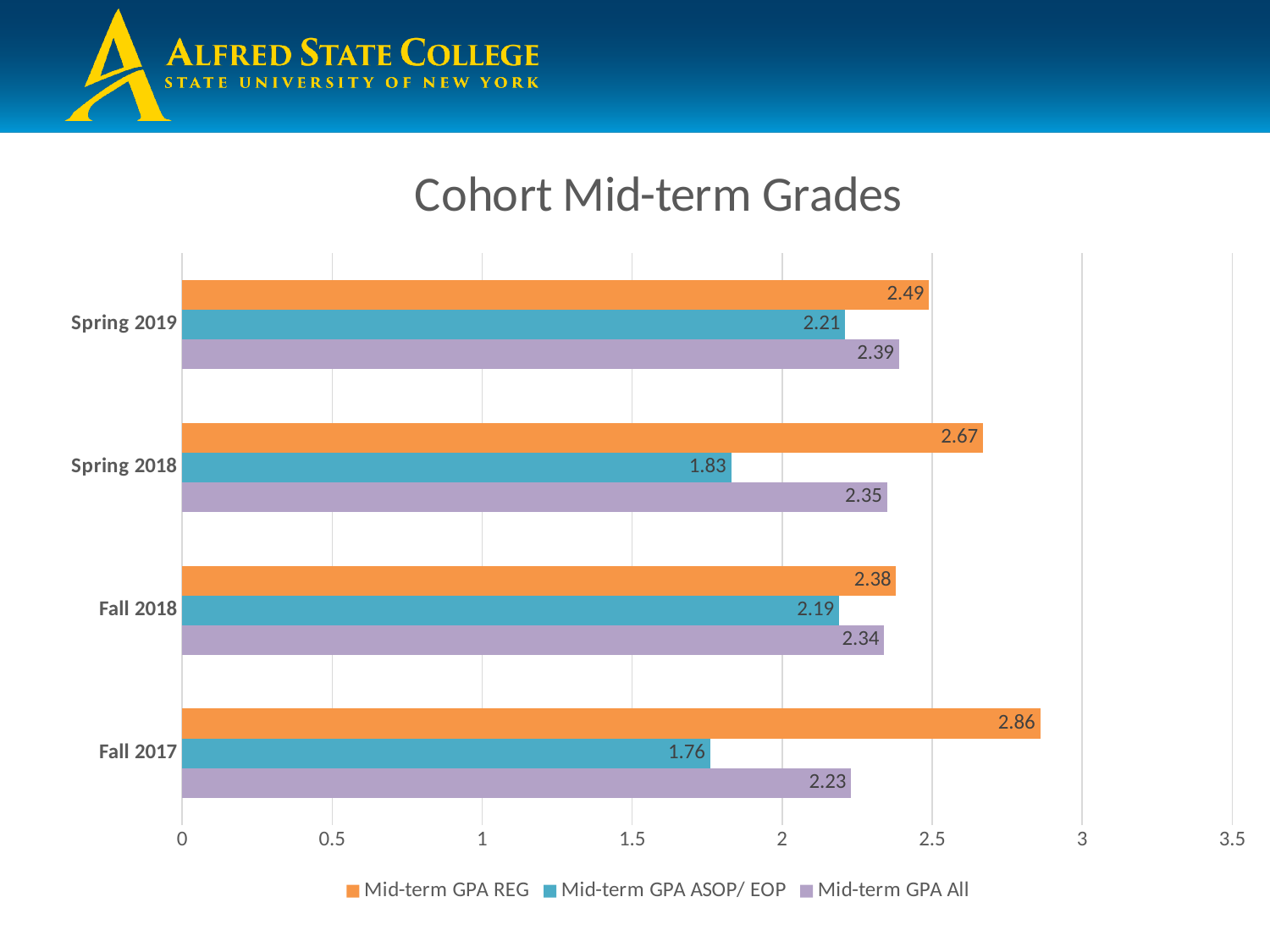
Which cohort has the lowest Mid-term GPA ASOP/ EOP? Fall 2017 How many series does the legend list? 3 How many cohorts are shown on the chart? 4 What kind of chart is shown on the slide? Bar chart What is the title of the chart? Cohort Mid-term Grades Which is larger for Spring 2018: Mid-term GPA REG or Mid-term GPA All? Mid-term GPA REG What is the Mid-term GPA REG value for Fall 2017? 2.86 Is the Mid-term GPA ASOP/ EOP value for Spring 2019 greater or less than 2? greater What is the Mid-term GPA ASOP/ EOP value for Spring 2018? 1.83 What is the difference between the Mid-term GPA REG and Mid-term GPA ASOP/ EOP values for Fall 2017? 1.10 What is the Mid-term GPA All value for Spring 2019? 2.39 Which cohort has the highest Mid-term GPA REG? Fall 2017